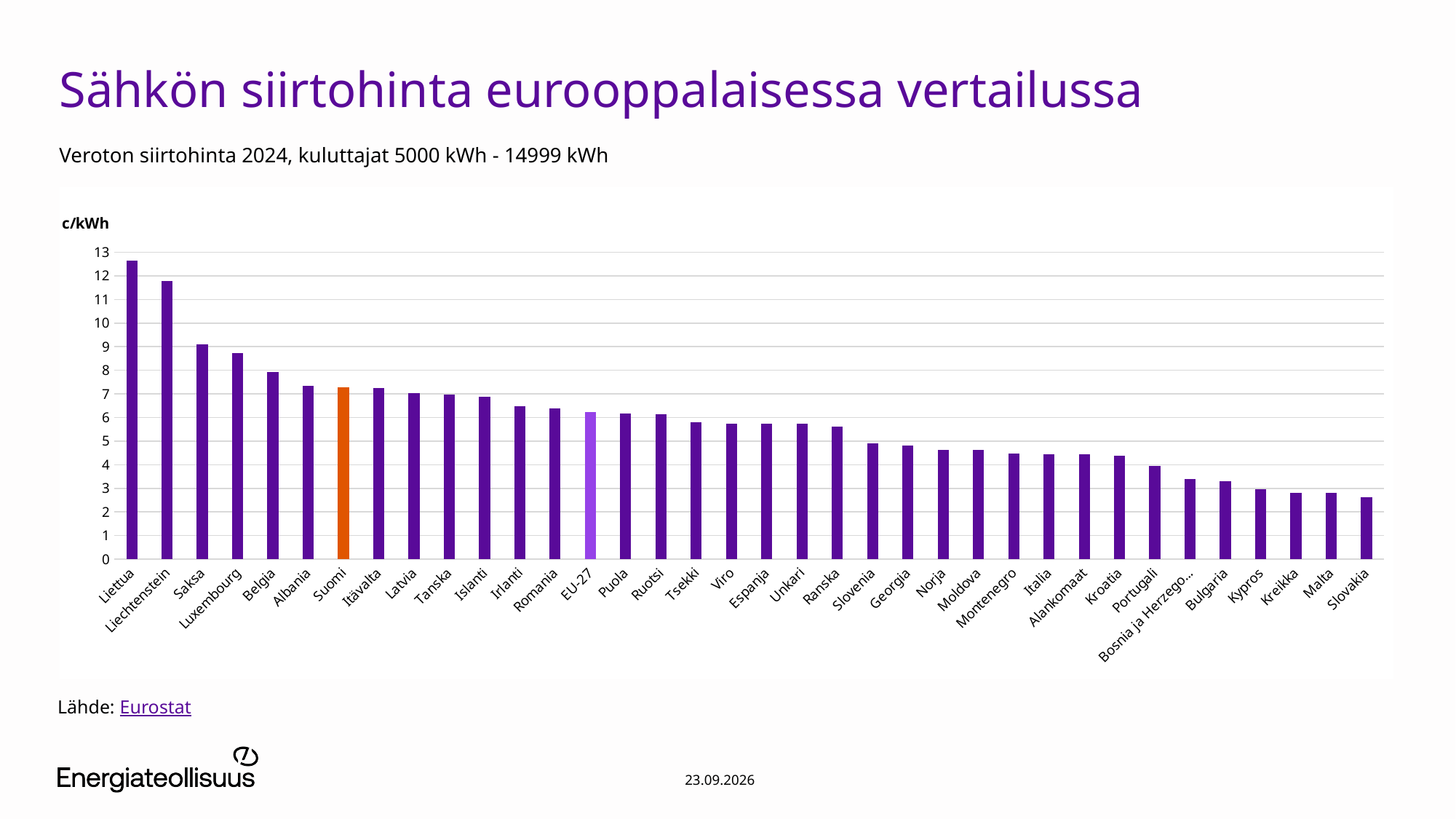
Which has a higher transmission price, Suomi or EU-27? Suomi Which country's bar is highlighted in orange? Suomi What kind of chart is shown on the slide? bar chart Is the value for Bulgaria greater or less than 4 c/kWh? less Is the value for Liettua greater or less than 12 c/kWh? greater Which country has the lowest transmission price in the chart? Slovakia Is the value for EU-27 greater or less than 7 c/kWh? less Which has a higher transmission price, Ruotsi or Norja? Ruotsi Which country has the highest transmission price in the chart? Liettua Do the bar values rise or fall from left to right along the x axis? fall How many countries or regions are shown as bars in the chart? 36